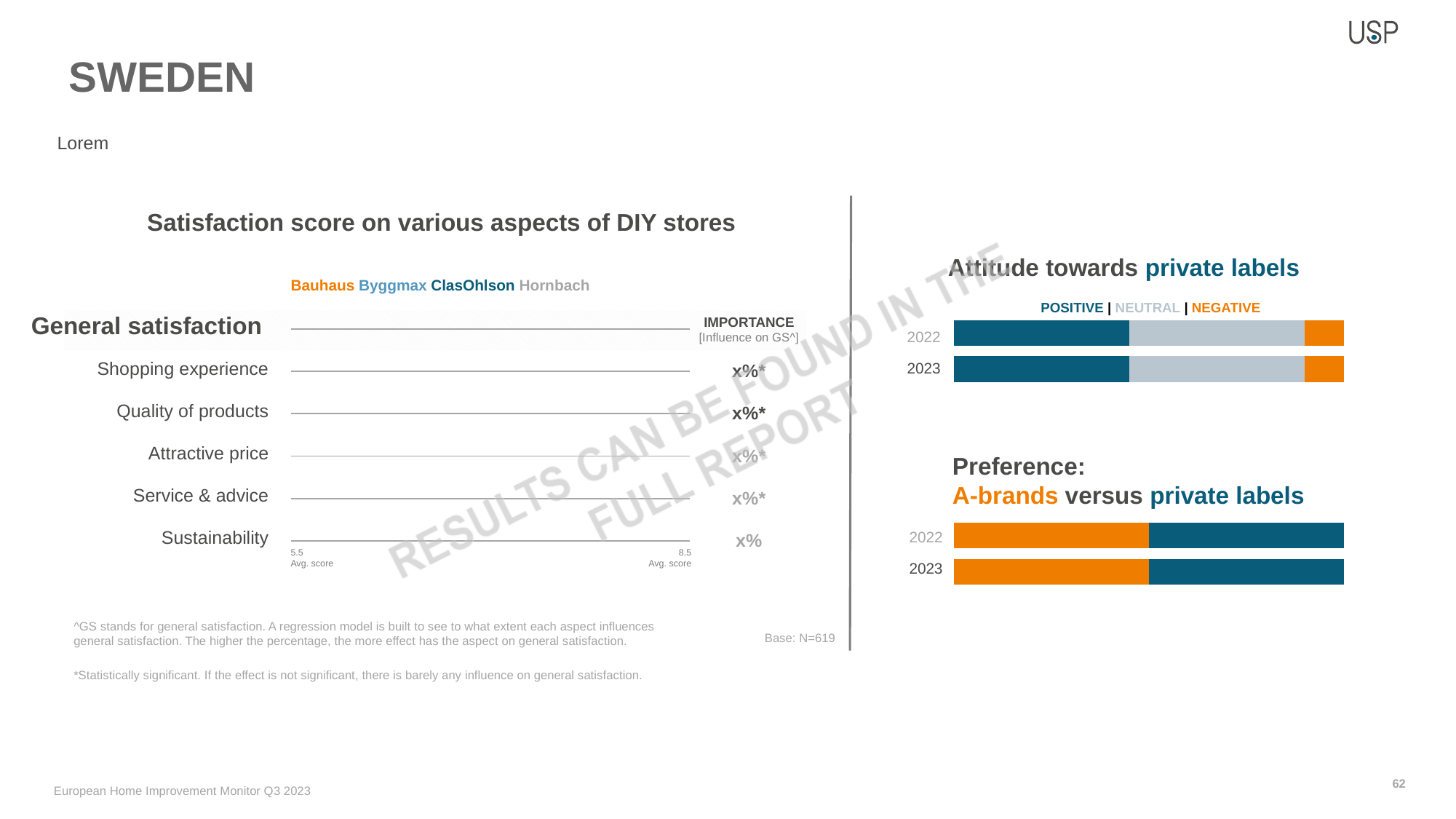
In the 'Satisfaction score on various aspects of DIY stores' chart, how many retailers does the legend list? 4 In the 'Preference: A-brands versus private labels' chart, how many series are shown? 2 In the 'Satisfaction score on various aspects of DIY stores' chart, how many aspects are listed below 'General satisfaction'? 5 In the 'Attitude towards private labels' chart, which is larger for 2022: the neutral segment or the negative segment? neutral In the 'Attitude towards private labels' chart, what kind of chart is it? stacked bar chart In the 'Attitude towards private labels' chart, which attitude has the smallest segment in 2023? Negative In the 'Attitude towards private labels' chart, which colour represents the negative attitude? orange In the 'Attitude towards private labels' chart, how many years are shown? 2 In the 'Attitude towards private labels' chart, which is larger for 2023: the positive segment or the negative segment? positive In the 'Satisfaction score on various aspects of DIY stores' chart, what are the minimum and maximum values shown on the average score axis? 5.5 and 8.5 In the 'Preference: A-brands versus private labels' chart, what kind of chart is it? stacked bar chart In the 'Attitude towards private labels' chart, how many series does the legend list? 3